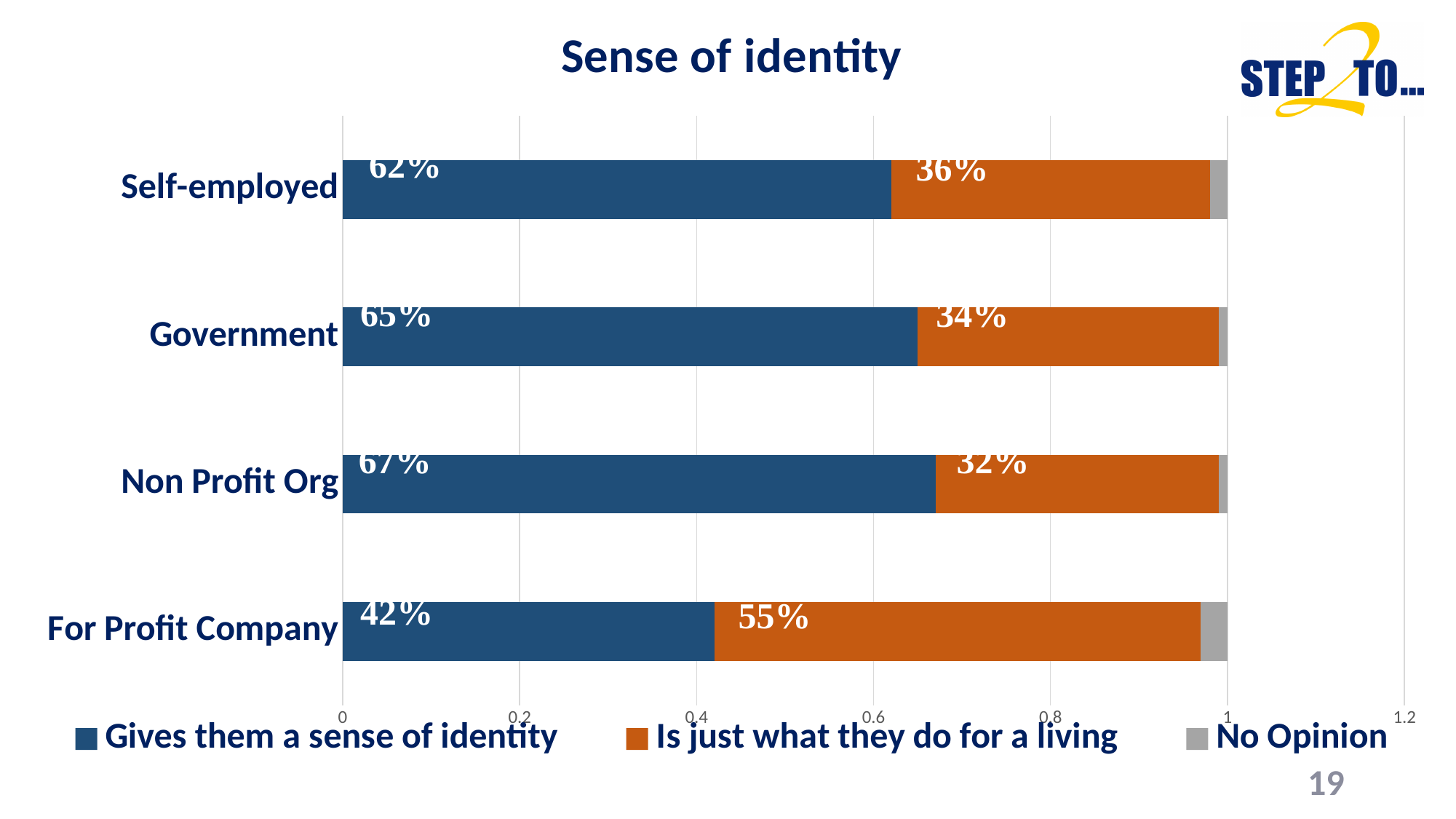
What type of chart is shown on the slide? Stacked bar chart Which is larger for Self-employed: 'Gives them a sense of identity' or 'Is just what they do for a living'? Gives them a sense of identity What is the difference between the 'Gives them a sense of identity' values for Non Profit Org and For Profit Company? 25% What is the value for 'Is just what they do for a living' for For Profit Company? 55% Which category has the highest 'Gives them a sense of identity' value? Non Profit Org Is the 'Gives them a sense of identity' value for Government greater or less than 0.6? greater What is the 'Is just what they do for a living' value for Government? 34% How many series does the legend list? 3 Which category has the lowest 'Gives them a sense of identity' value? For Profit Company How many categories are shown on the chart? 4 What is the 'Gives them a sense of identity' value for Non Profit Org? 67% What percentage of Self-employed respondents say work gives them a sense of identity? 62%